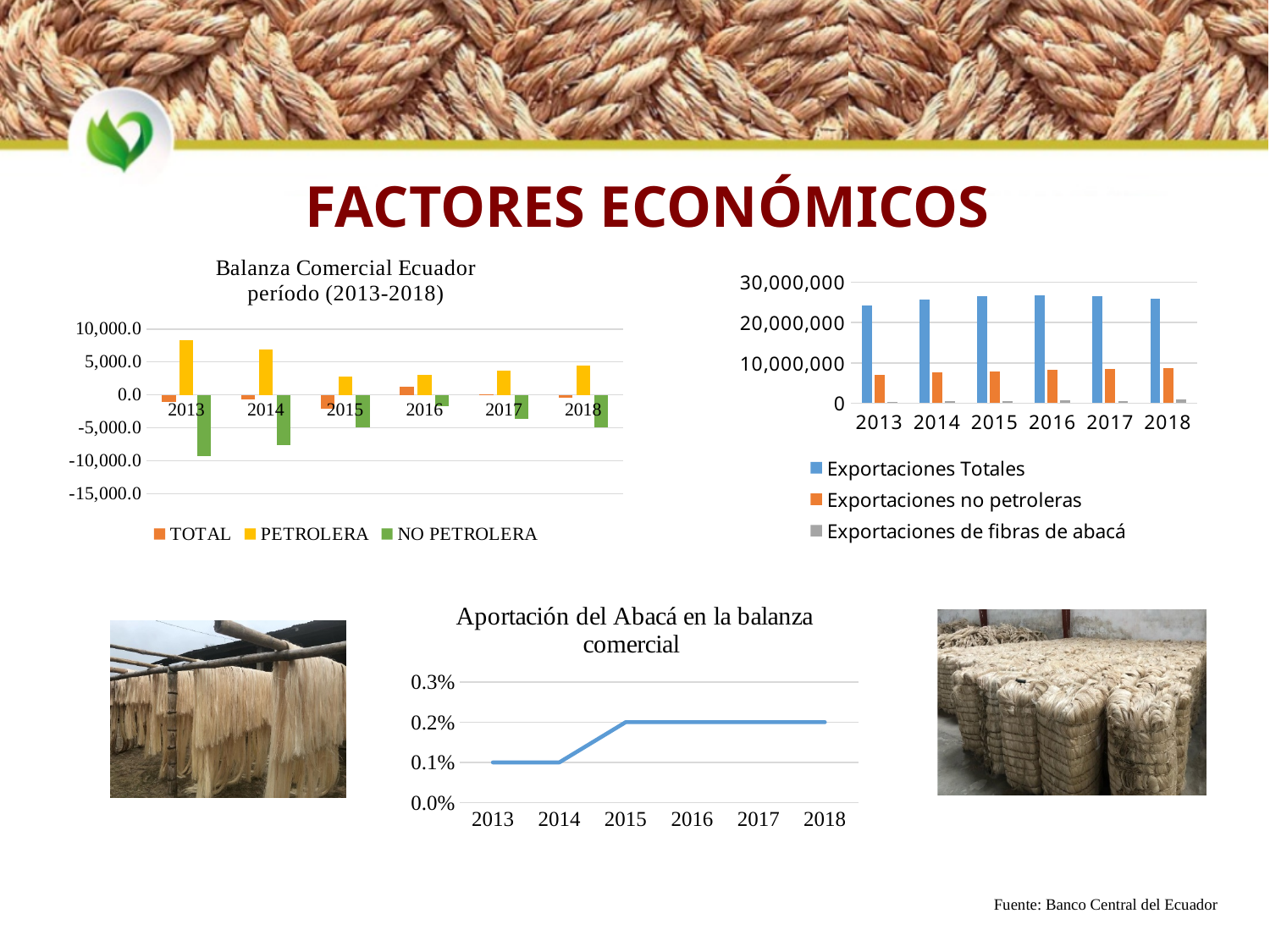
In the top-right bar chart with the 'Exportaciones Totales' legend, how many years are shown on the x axis? 6 In the 'Balanza Comercial Ecuador período (2013-2018)' chart, is the NO PETROLERA value for 2016 greater or less than -5,000.0? greater In the top-right bar chart with the 'Exportaciones Totales' legend, is the value of Exportaciones Totales for 2013 greater or less than 20,000,000? greater In the 'Aportación del Abacá en la balanza comercial' chart, what is the value for 2013? 0.1% In the top-right bar chart with the 'Exportaciones Totales' legend, is the value of Exportaciones no petroleras for 2018 greater or less than 10,000,000? less In the 'Balanza Comercial Ecuador período (2013-2018)' chart, which series is shown in green? NO PETROLERA In the 'Balanza Comercial Ecuador período (2013-2018)' chart, which year has the highest PETROLERA value? 2013 In the 'Aportación del Abacá en la balanza comercial' chart, what is the value for 2017? 0.2% In the 'Balanza Comercial Ecuador período (2013-2018)' chart, how many series does the legend list? 3 In the top-right bar chart with the 'Exportaciones Totales' legend, which series has the smallest bars in every year? Exportaciones de fibras de abacá What kind of chart is 'Aportación del Abacá en la balanza comercial'? line chart